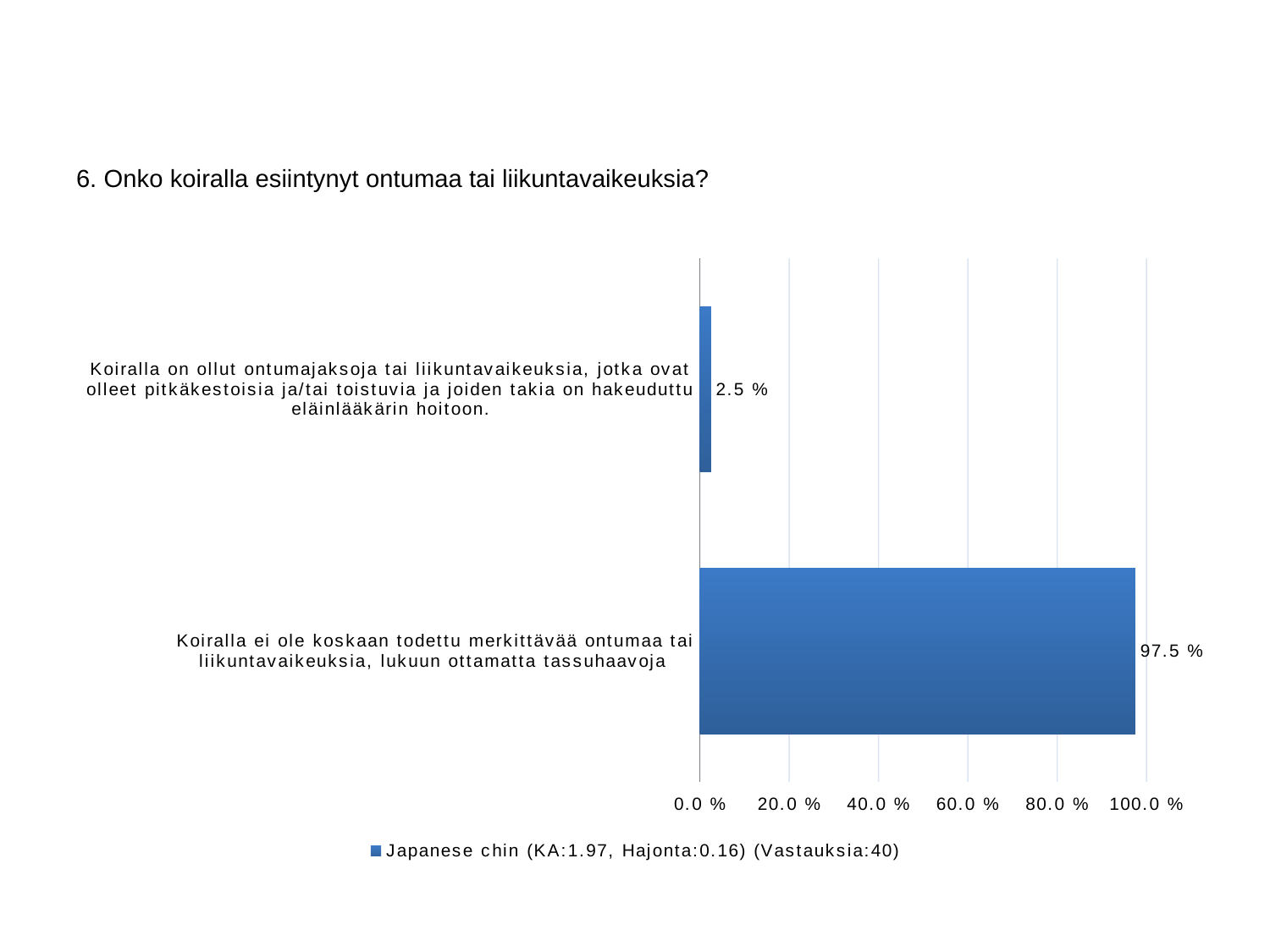
How many series does the legend list? 1 Which category has the highest value? Koiralla ei ole koskaan todettu merkittävää ontumaa tai liikuntavaikeuksia, lukuun ottamatta tassuhaavoja What percentage of dogs have never had significant lameness or mobility problems, apart from paw wounds ("Koiralla ei ole koskaan todettu merkittävää ontumaa tai liikuntavaikeuksia, lukuun ottamatta tassuhaavoja")? 97.5 % How many categories are shown in the chart? 2 What percentage of dogs have had prolonged and/or recurring lameness episodes requiring veterinary care ("Koiralla on ollut ontumajaksoja tai liikuntavaikeuksia...")? 2.5 % How many responses (Vastauksia) does the legend entry report? 40 Is the value for "Koiralla ei ole koskaan todettu merkittävää ontumaa tai liikuntavaikeuksia" greater or less than 80.0 %? greater What kind of chart is shown on the slide? Bar chart Is the value for "Koiralla on ollut ontumajaksoja tai liikuntavaikeuksia" greater or less than 20.0 %? less Which category has the lowest value? Koiralla on ollut ontumajaksoja tai liikuntavaikeuksia, jotka ovat olleet pitkäkestoisia ja/tai toistuvia ja joiden takia on hakeuduttu eläinlääkärin hoitoon. What is the title of the chart? 6. Onko koiralla esiintynyt ontumaa tai liikuntavaikeuksia? What is the difference in percentage points between the two categories? 95.0 %